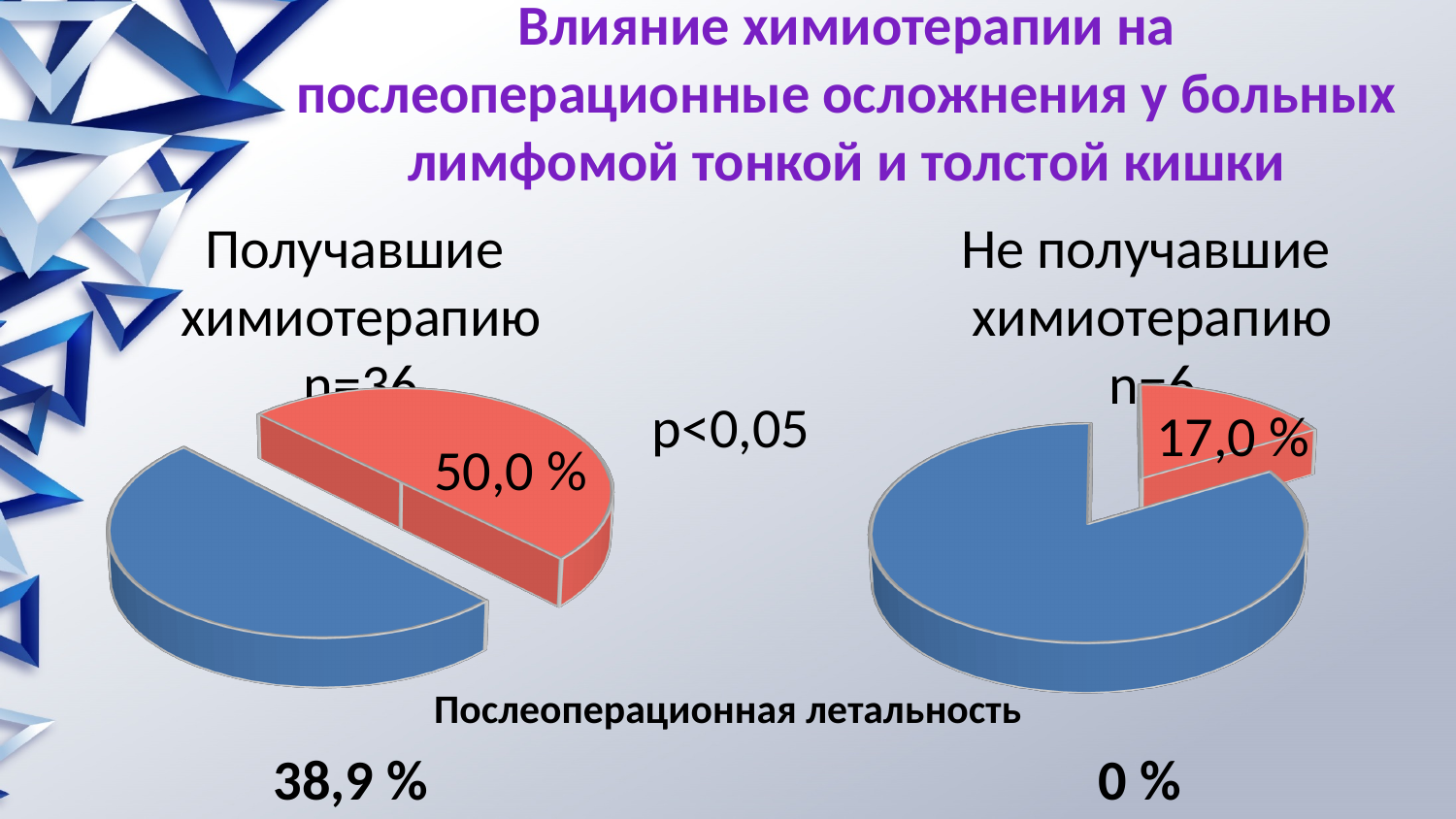
What kind of chart is shown on the left side of the slide (Получавшие химиотерапию)? pie chart What p-value is printed between the two pie charts? p<0,05 In the right pie chart (Не получавшие химиотерапию), what value is printed on the red slice? 17,0 % What colour is the larger slice in the right pie chart (Не получавшие химиотерапию)? blue How many slices does the left pie chart (Получавшие химиотерапию) have? 2 In the left pie chart (Получавшие химиотерапию), what share of the pie does the red slice represent? 50,0 % Which pie chart has the larger red slice, the left one (Получавшие химиотерапию) or the right one (Не получавшие химиотерапию)? the left one (Получавшие химиотерапию) What is the difference between the red slice value in the left pie chart (50,0 %) and the red slice value in the right pie chart (17,0 %)? 33,0 % In the left pie chart (Получавшие химиотерапию), what value is printed on the red slice? 50,0 % What kind of chart is shown on the right side of the slide (Не получавшие химиотерапию)? pie chart How many slices does the right pie chart (Не получавшие химиотерапию) have? 2 In the right pie chart (Не получавшие химиотерапию), is the red slice's share greater or less than 50%? less